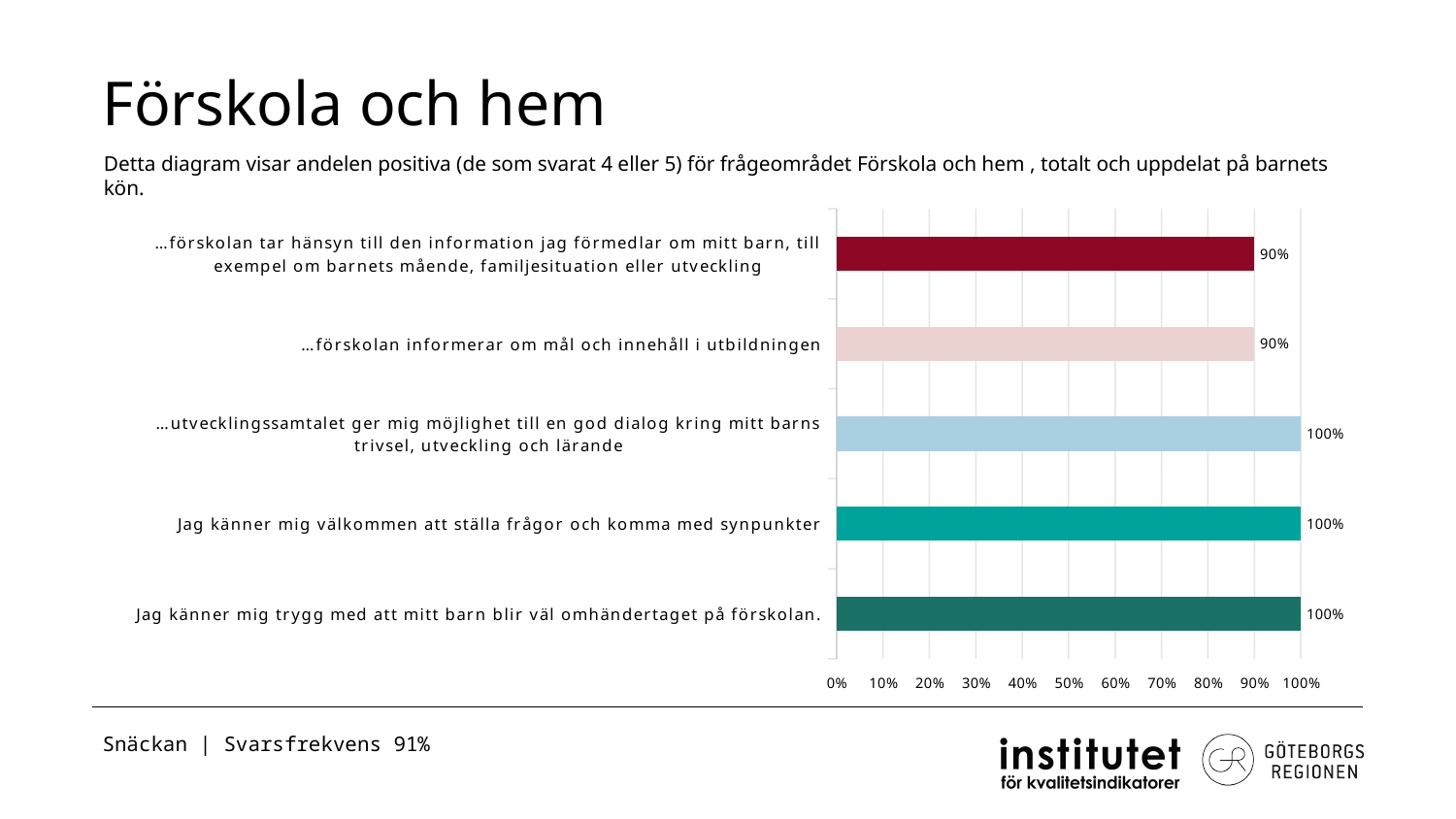
What is the value for "…utvecklingssamtalet ger mig möjlighet till en god dialog kring mitt barns trivsel, utveckling och lärande"? 100% How many categories (bars) does the chart show? 5 What kind of chart is shown on the slide? Bar chart What is the value for "…förskolan informerar om mål och innehåll i utbildningen"? 90% What is the value for "…förskolan tar hänsyn till den information jag förmedlar om mitt barn, till exempel om barnets mående, familjesituation eller utveckling"? 90% What is the difference between the value for "Jag känner mig välkommen att ställa frågor och komma med synpunkter" and the value for "…förskolan informerar om mål och innehåll i utbildningen"? 10% What is the value for "Jag känner mig välkommen att ställa frågor och komma med synpunkter"? 100% What is the value for "Jag känner mig trygg med att mitt barn blir väl omhändertaget på förskolan."? 100% Which is larger: the value for "Jag känner mig trygg med att mitt barn blir väl omhändertaget på förskolan." or the value for "…förskolan informerar om mål och innehåll i utbildningen"? Jag känner mig trygg med att mitt barn blir väl omhändertaget på förskolan. How many categories have a value of 100%? 3 What is the title of the slide containing the chart? Förskola och hem Is the value for "…förskolan informerar om mål och innehåll i utbildningen" greater or less than 50%? greater